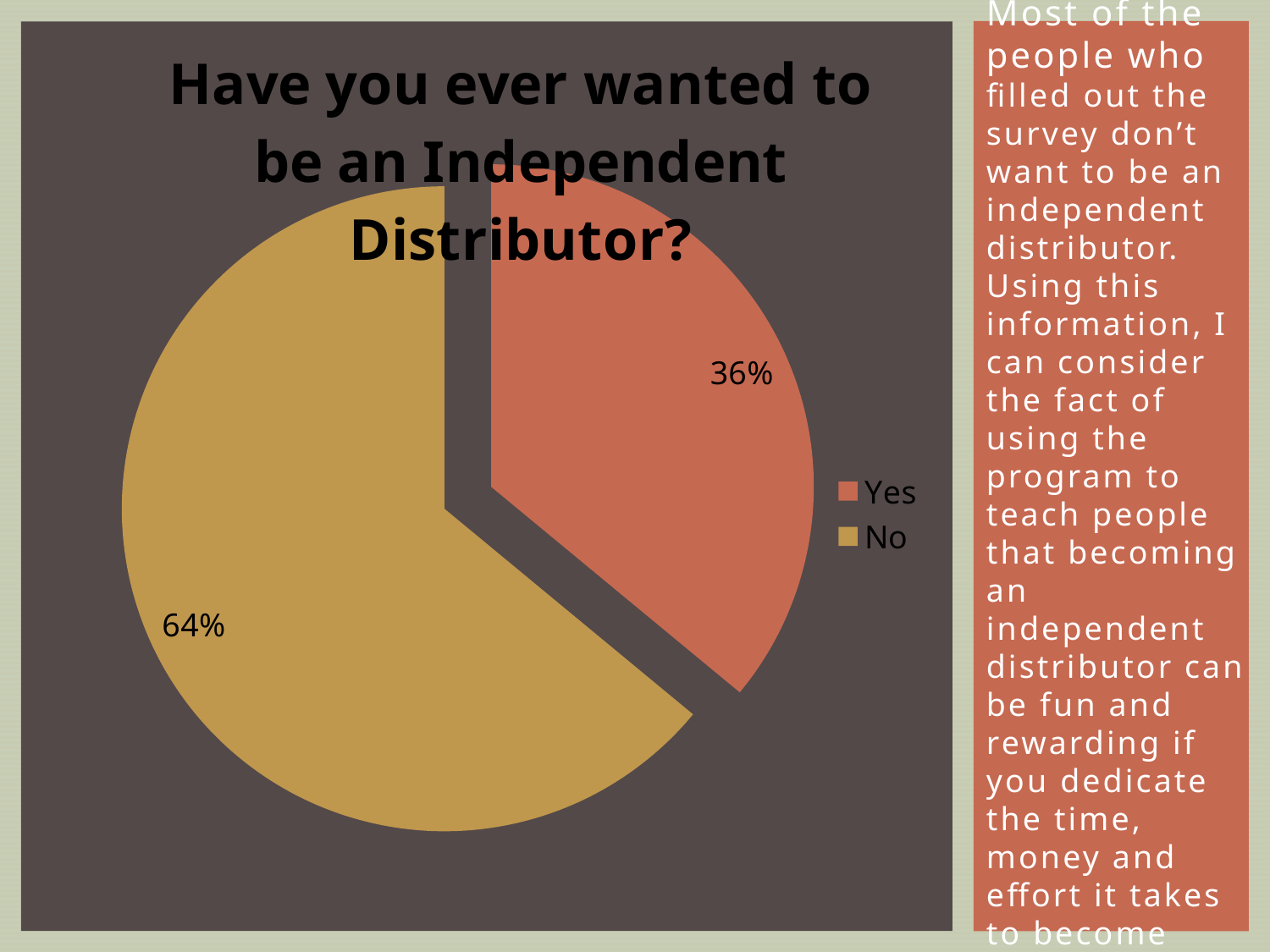
Which slice is the smallest? Yes What colour is the "No" slice? gold How many slices does the pie chart have? 2 What is the title of the chart? Have you ever wanted to be an Independent Distributor? How many entries does the legend list? 2 What share of the pie is labelled "No"? 64% Which slice is the largest? No What kind of chart is shown on the slide? pie chart Which is larger, the "Yes" slice or the "No" slice? No What share of the pie is labelled "Yes"? 36% What is the difference in percentage points between the "No" and "Yes" slices? 28